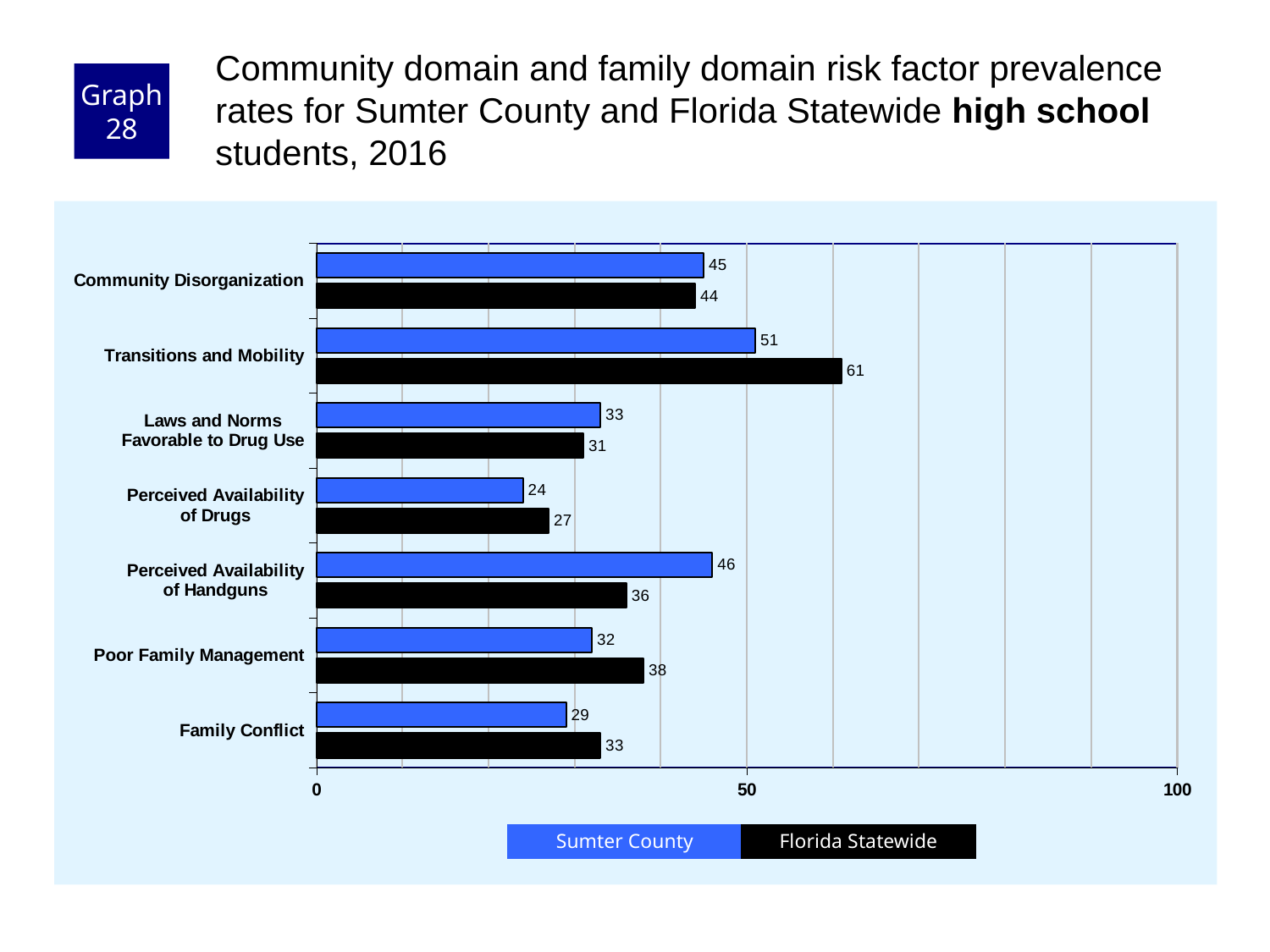
How many risk factor categories are shown on the chart? 7 Is the Florida Statewide value for Transitions and Mobility greater or less than 50? greater What is the Sumter County value for Family Conflict? 29 What is the Florida Statewide value for Perceived Availability of Handguns? 36 Which risk factor has the lowest Sumter County value? Perceived Availability of Drugs Which colour represents Sumter County in the chart? Blue Which risk factor has the highest Florida Statewide value? Transitions and Mobility What kind of chart is shown on the slide? Bar chart What is the Sumter County value for Transitions and Mobility? 51 What is the difference between the Florida Statewide and Sumter County values for Transitions and Mobility? 10 Which is larger for Poor Family Management: the Sumter County value or the Florida Statewide value? Florida Statewide How many series does the legend list? 2